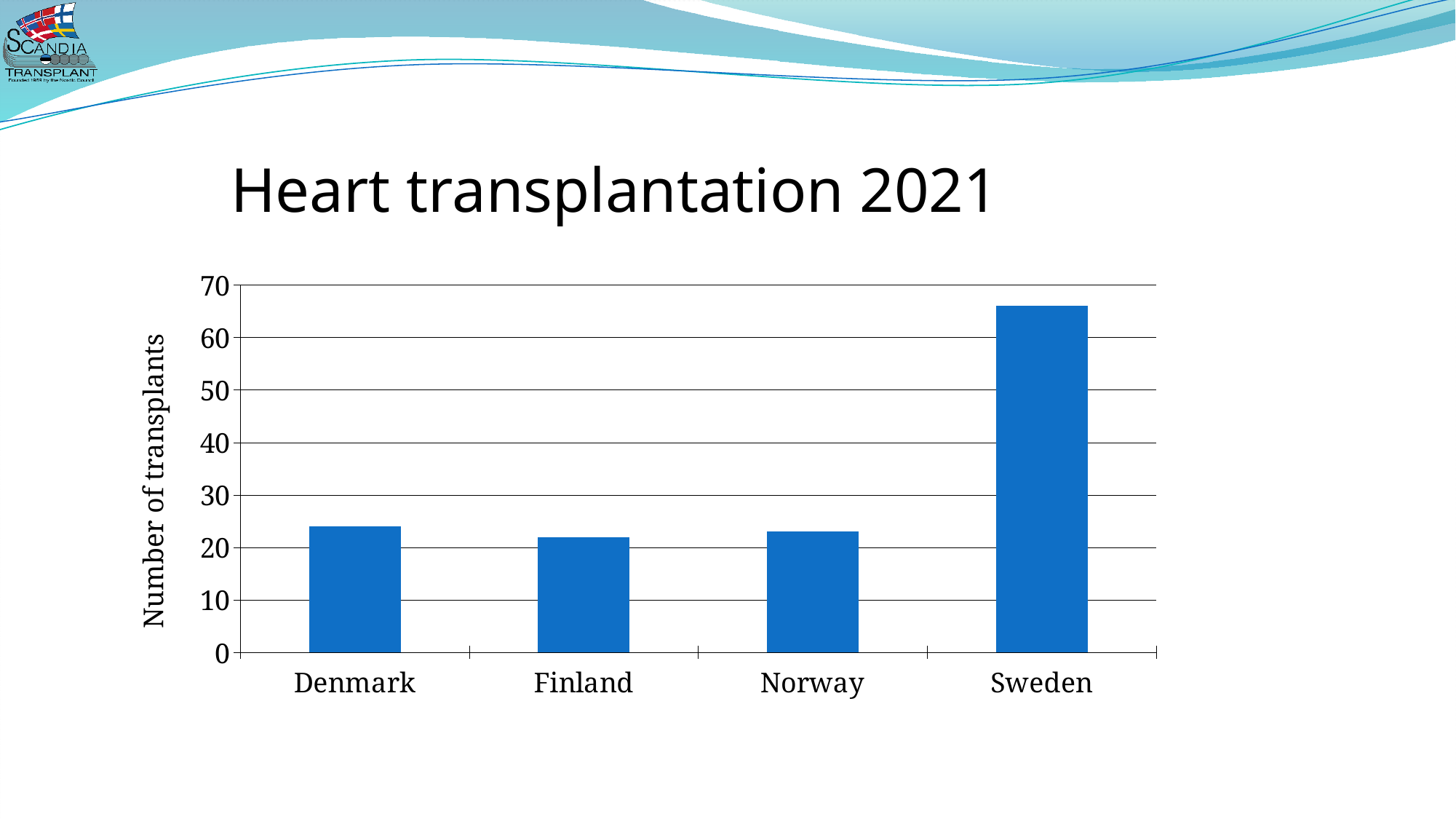
Which country has the highest number of heart transplants in the chart? Sweden Which has a higher number of transplants, Sweden or Norway? Sweden What is the label on the vertical axis of the chart? Number of transplants Is the value for Finland greater or less than 30? less What type of chart is shown on the slide? bar chart Is the value for Sweden greater or less than 60? greater Which has a lower number of transplants, Denmark or Sweden? Denmark What is the title of the chart? Heart transplantation 2021 How many countries are shown on the x axis of the chart? 4 Is the value for Norway greater or less than 20? greater